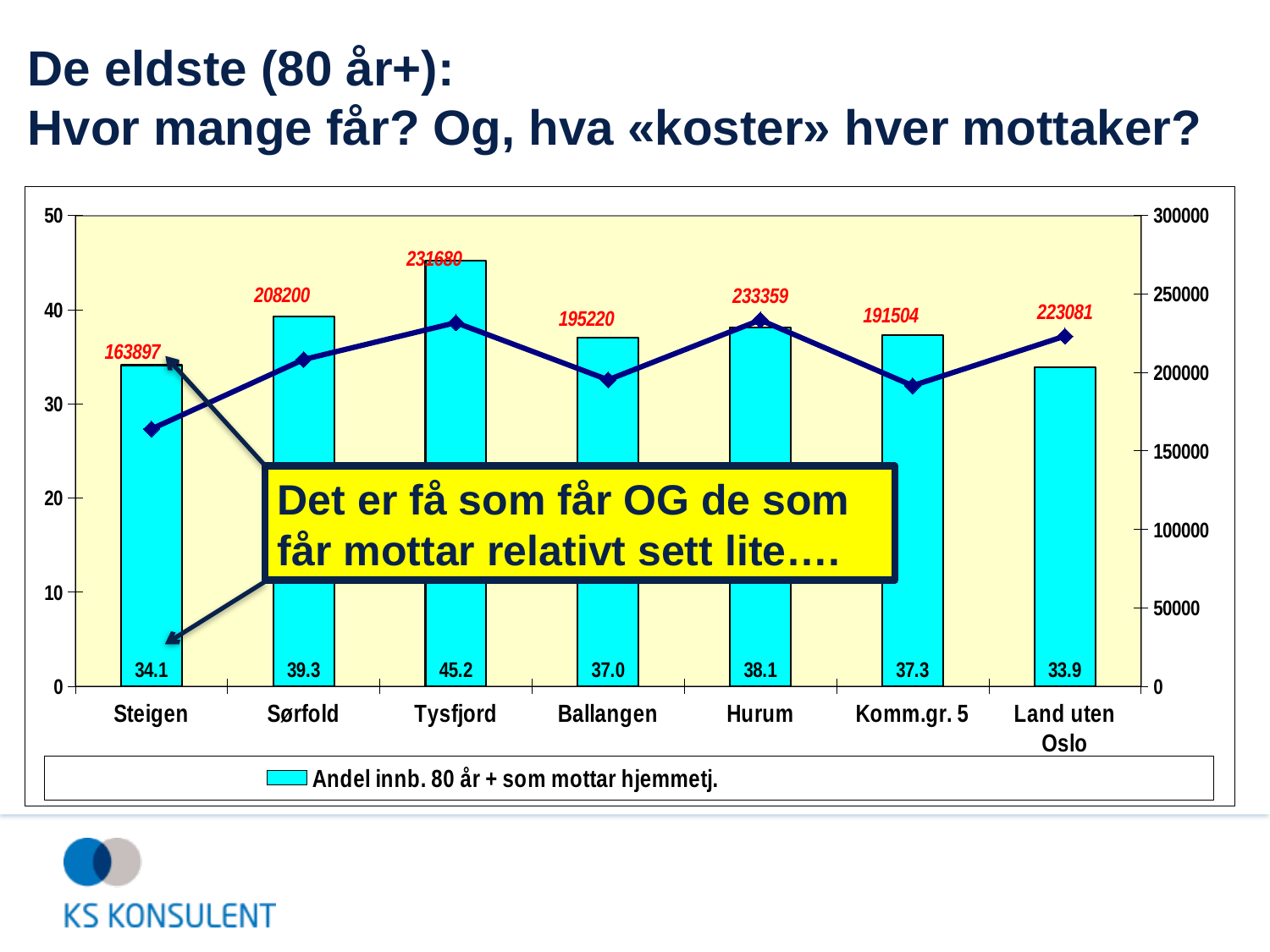
What is the difference between the bar values for Tysfjord and Steigen? 11.1 Which category has the lowest value on the line series (red labels)? Steigen Which has the larger bar value, Sørfold or Hurum? Sørfold Which category has the lowest bar? Land uten Oslo What is the red-labelled line value shown for Hurum? 233359 Which category has the highest bar? Tysfjord What is the red-labelled line value shown for Steigen? 163897 What is the value of the bar for Tysfjord? 45.2 What is the legend entry shown below the chart? Andel innb. 80 år + som mottar hjemmetj. How many categories are shown on the x axis? 7 What is the value of the bar for Land uten Oslo? 33.9 How many series does the legend list? 1